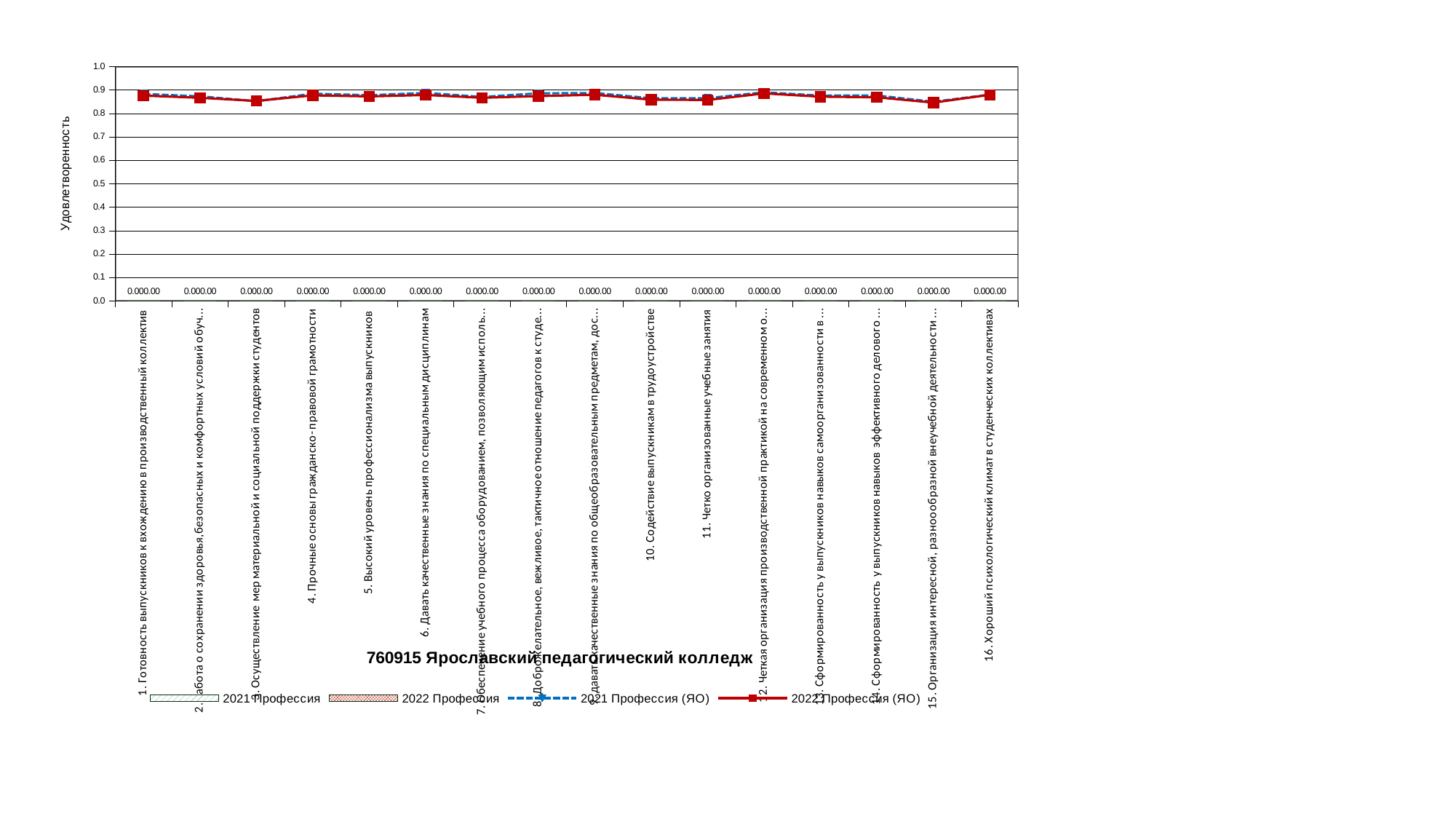
Is the value of the 2021 Профессия (ЯО) series for category 11 (Четко организованные учебные занятия) greater or less than 0.8? greater Is the value of the 2022 Профессия (ЯО) series for category 15 (Организация интересной, разнообразной внеучебной деятельности) greater or less than 0.9? less How many categories are plotted along the x axis of the chart? 16 How many series does the chart legend list? 4 Is the value of the 2022 Профессия (ЯО) series for category 1 (Готовность выпускников к вхождению в производственный коллектив) greater or less than 0.7? greater What is the label of the vertical axis of the chart? Удовлетворенность What is the highest tick value shown on the vertical axis of the chart? 1.0 What is the title of the chart? 760915 Ярославский педагогический колледж